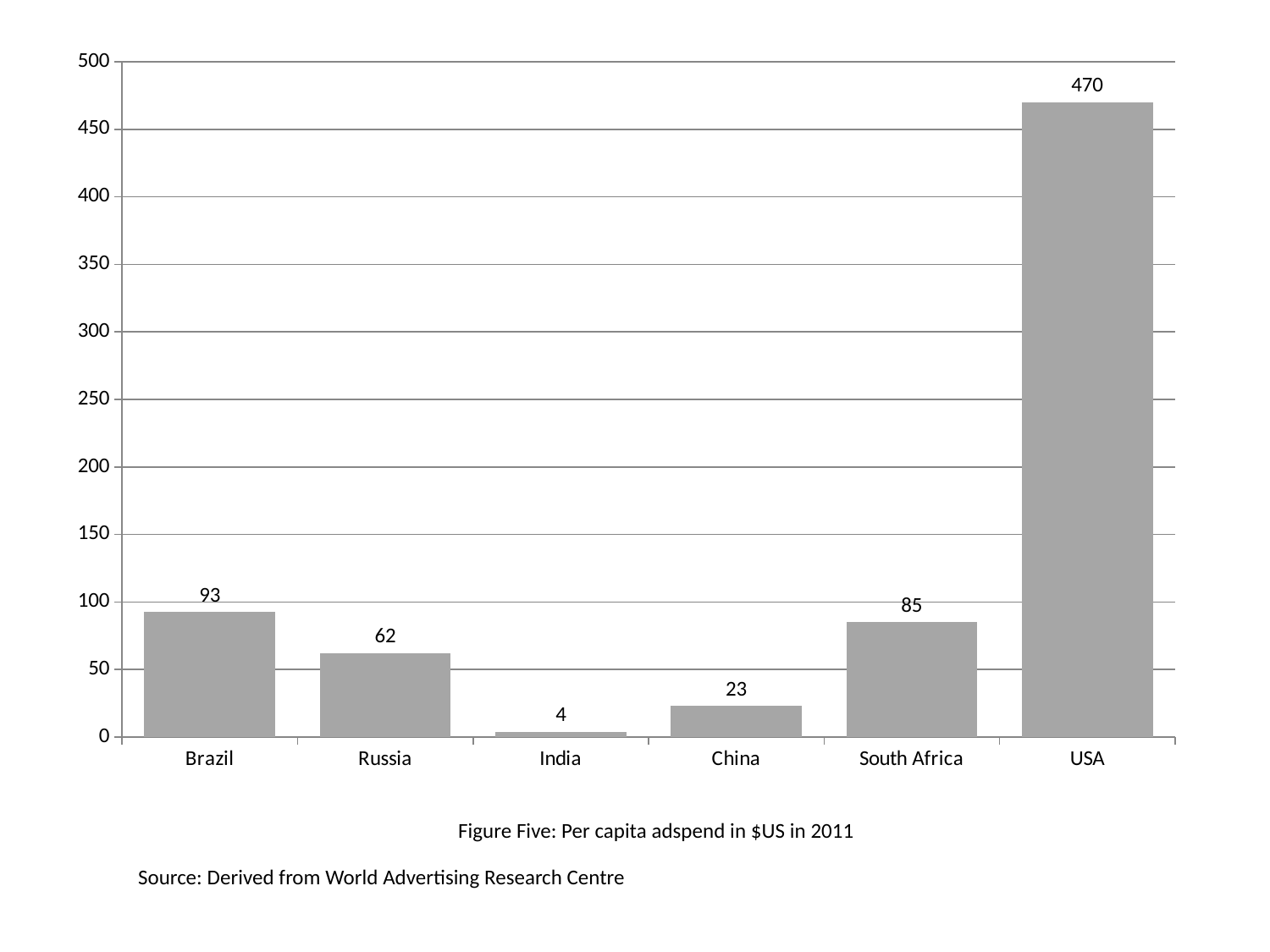
What is the per capita adspend value for South Africa? 85 What is the difference between the values for Russia and China? 39 Is the value for USA greater or less than 450? greater What kind of chart is shown on the slide? bar chart Which country has the lowest per capita adspend? India What is the figure caption shown below the chart? Figure Five: Per capita adspend in $US in 2011 How many countries are shown on the chart? 6 What is the difference between the values for USA and Brazil? 377 What is the per capita adspend value for Brazil? 93 Which country has the highest per capita adspend? USA Which is larger, the value for Brazil or the value for South Africa? Brazil What is the per capita adspend value for China? 23